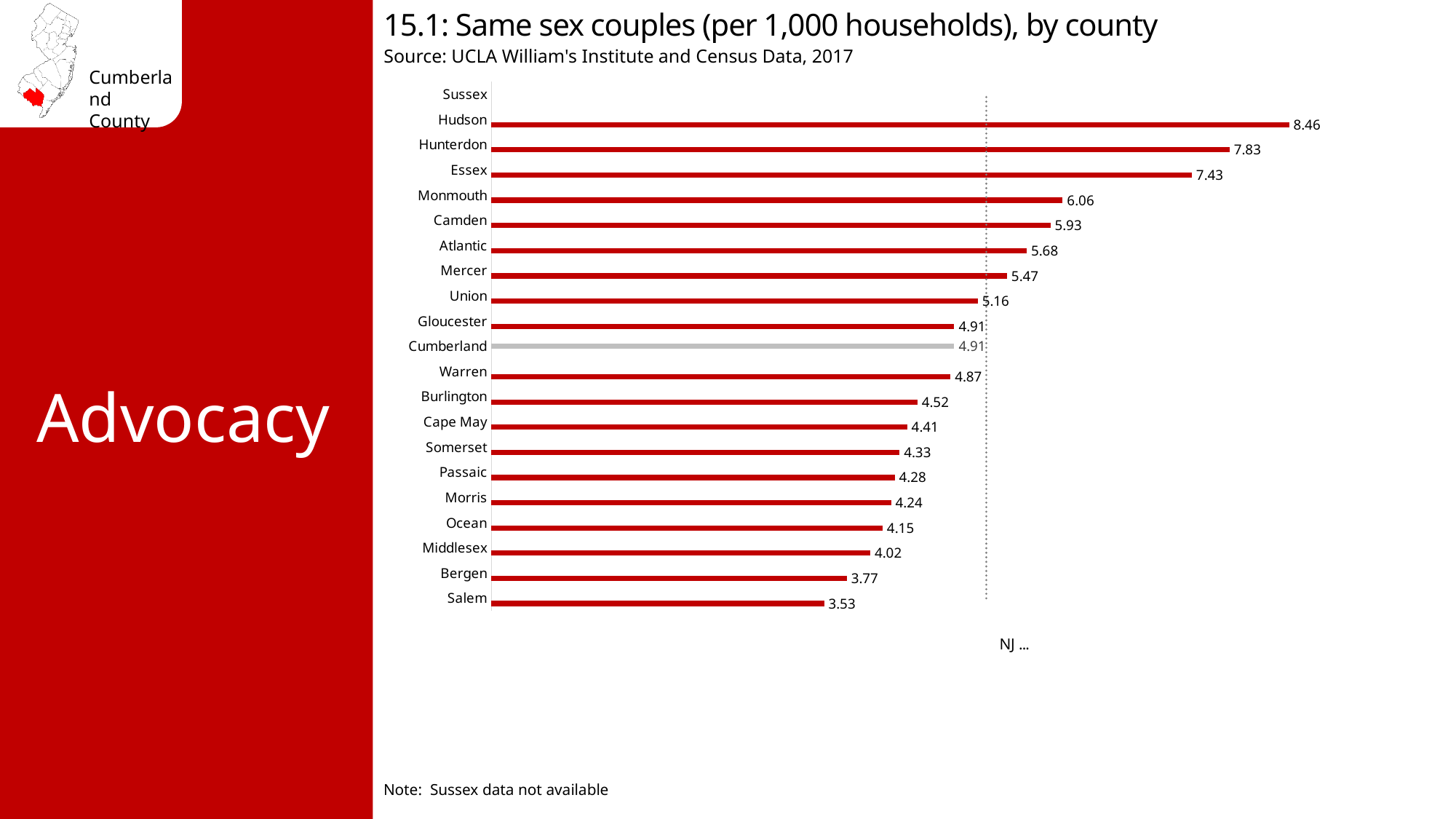
How many counties are listed on the y axis? 21 What is the value for Hudson? 8.46 Which county has the highest value shown? Hudson What is the title of the chart? 15.1: Same sex couples (per 1,000 households), by county Which county has the lowest value shown? Salem Which has a larger value, Monmouth or Camden? Monmouth Which county's bar is shown in grey rather than red? Cumberland What kind of chart is this? Bar chart What is the value for Cumberland? 4.91 What is the value for Salem? 3.53 Which has a larger value, Bergen or Middlesex? Middlesex What is the difference between the values for Hudson and Hunterdon? 0.63